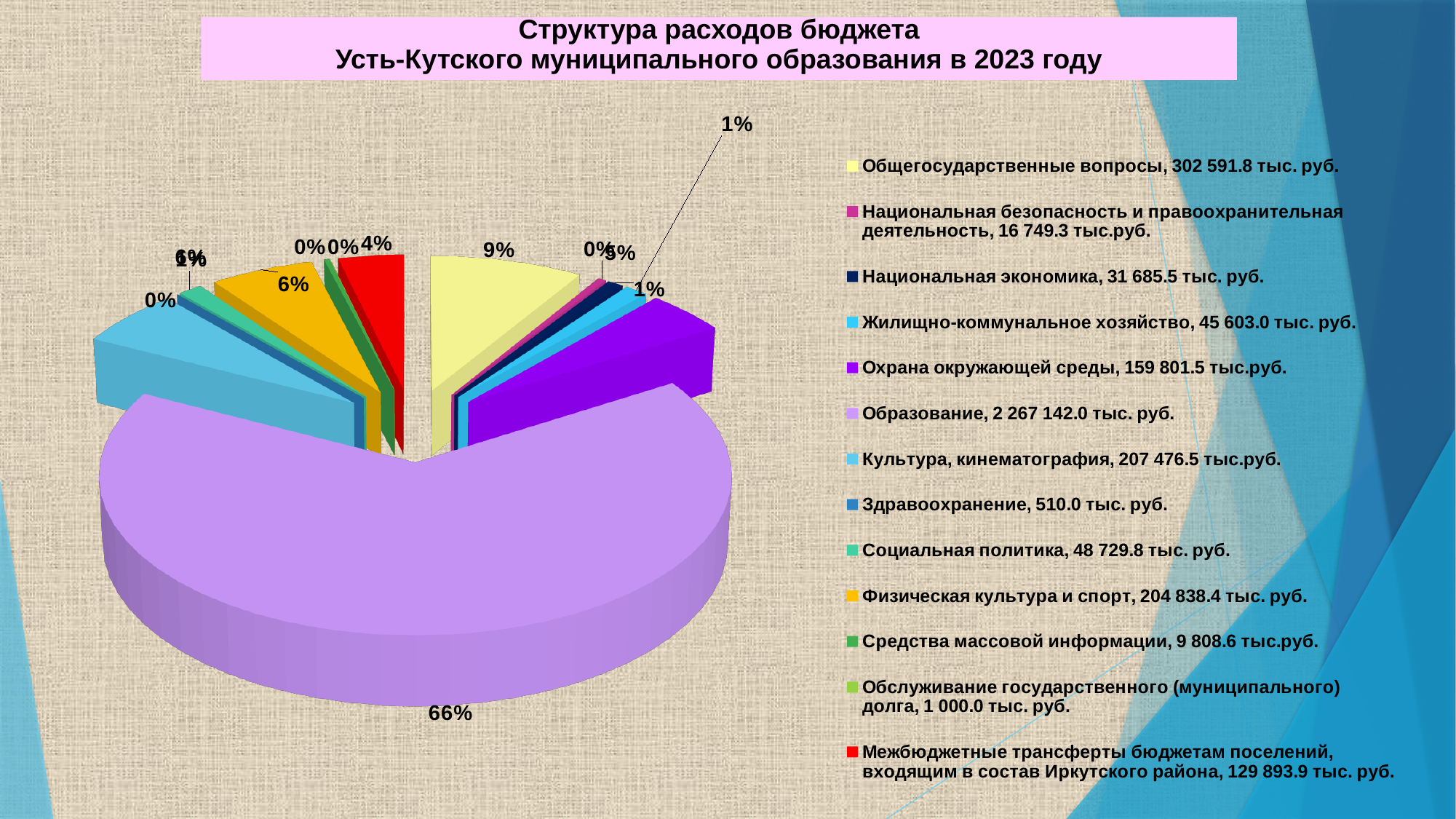
What is the amount shown for Здравоохранение? 510.0 тыс. руб. Which category has the smallest amount in the legend? Здравоохранение Which is larger: Охрана окружающей среды or Жилищно-коммунальное хозяйство? Охрана окружающей среды What is the title of the chart? Структура расходов бюджета Усть-Кутского муниципального образования в 2023 году What kind of chart is shown on the slide? pie chart What percentage label is shown on the Общегосударственные вопросы slice? 9% What is the difference between Национальная экономика (31 685.5) and Национальная безопасность и правоохранительная деятельность (16 749.3)? 14 936.2 тыс. руб. What is the amount shown for Образование in the legend? 2 267 142.0 тыс. руб. What share of the pie does Образование account for? 66% How many categories does the legend of the pie chart list? 13 What is the amount shown for Общегосударственные вопросы? 302 591.8 тыс. руб. Which category has the largest share of the budget expenditures? Образование